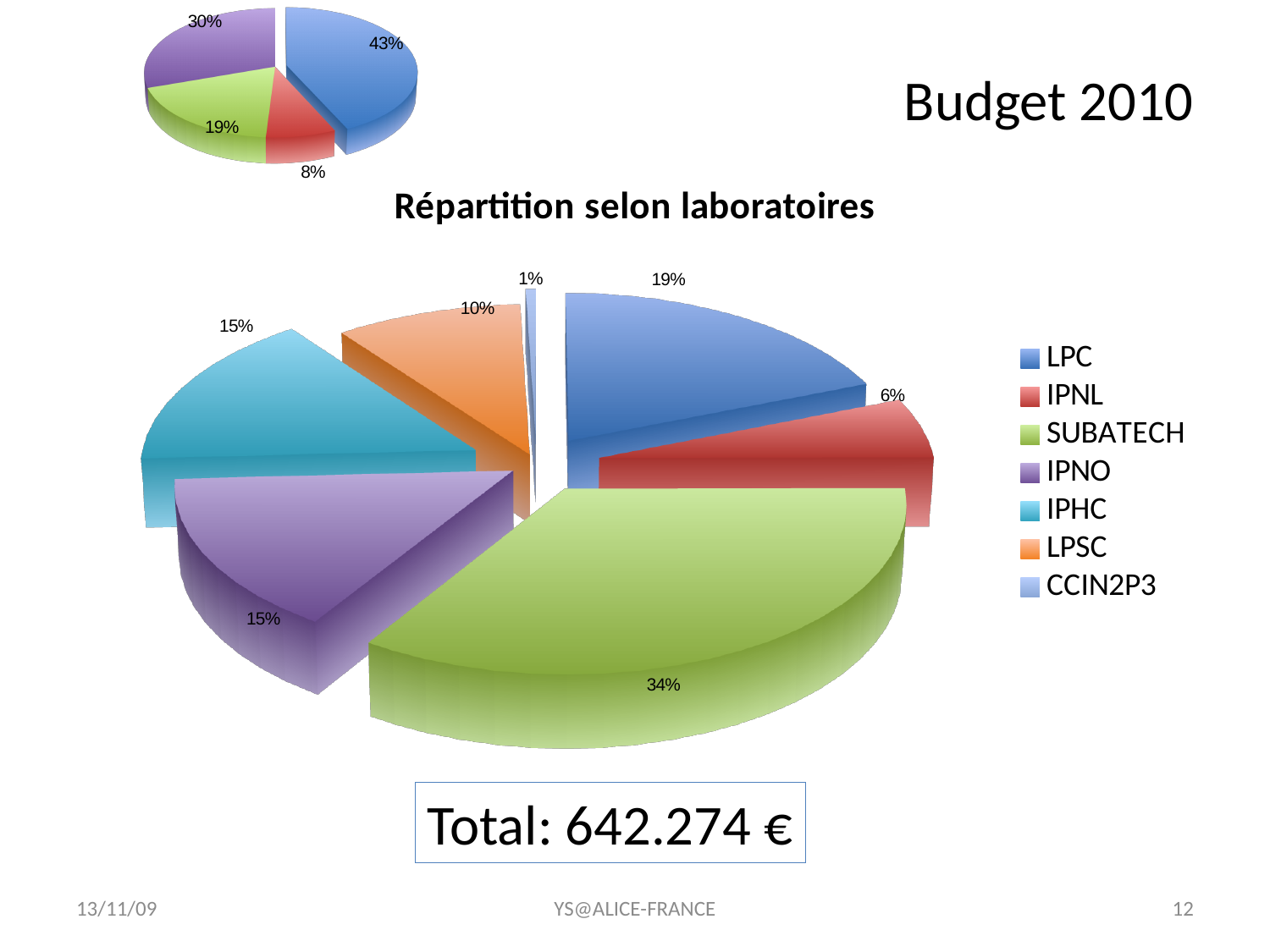
In the chart titled 'Répartition selon laboratoires', what share of the budget goes to LPC? 19% How many slices does the small pie chart at the top left of the slide have? 4 In the chart titled 'Répartition selon laboratoires', which laboratory has the smallest share? CCIN2P3 In the chart titled 'Répartition selon laboratoires', what share of the budget goes to SUBATECH? 34% What kind of chart is the chart titled 'Répartition selon laboratoires'? Pie chart How many laboratories does the legend of the chart titled 'Répartition selon laboratoires' list? 7 In the chart titled 'Répartition selon laboratoires', which has the larger share, LPC or LPSC? LPC In the chart titled 'Répartition selon laboratoires', what is the difference in percentage points between SUBATECH and IPNL? 28 In the small pie chart at the top left of the slide, what is the largest slice's percentage? 43% In the chart titled 'Répartition selon laboratoires', what share of the budget goes to CCIN2P3? 1% In the chart titled 'Répartition selon laboratoires', what share of the budget goes to LPSC? 10% In the chart titled 'Répartition selon laboratoires', which laboratory has the largest share? SUBATECH